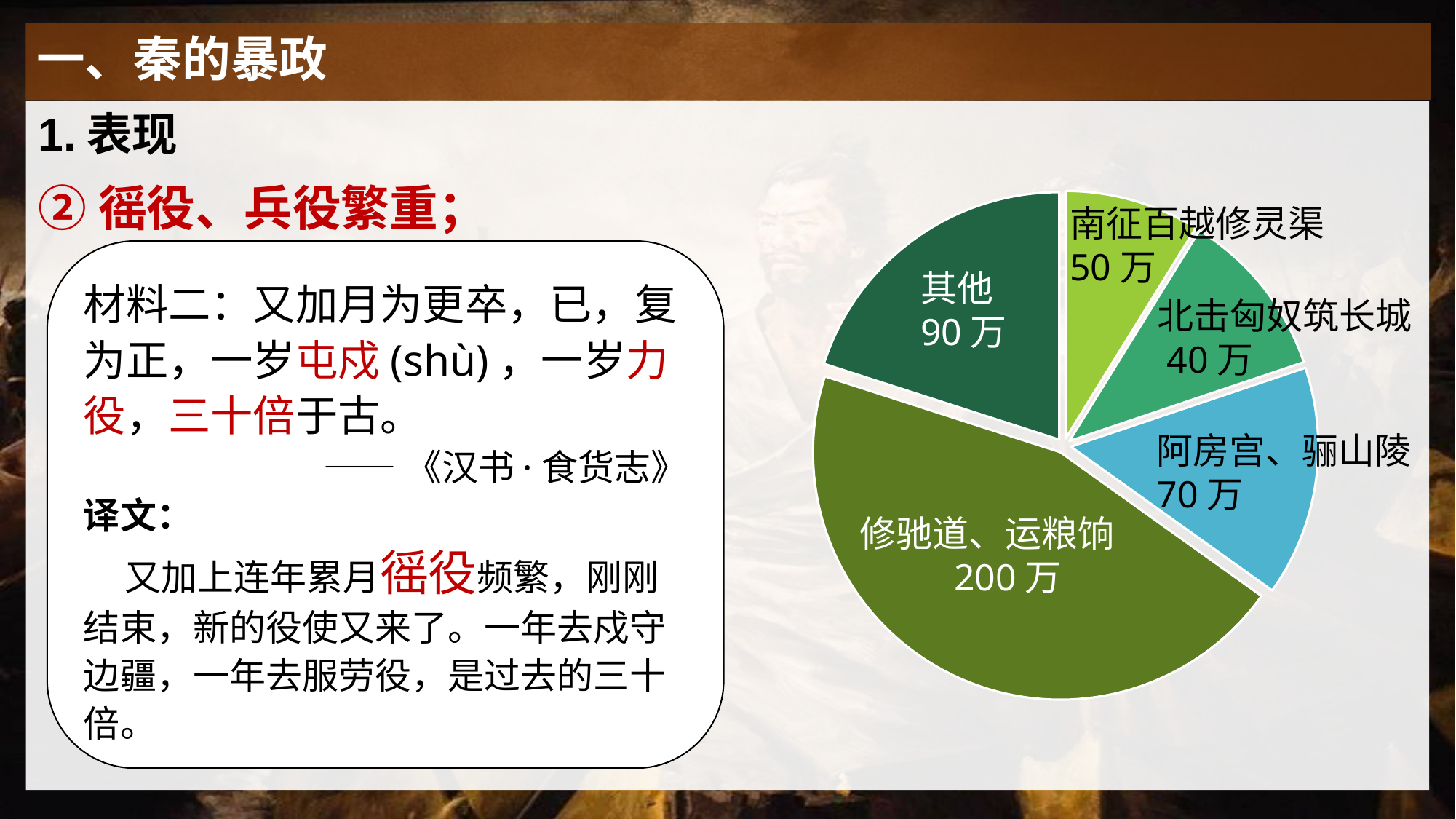
What share of the pie does 其他 represent? 20% What is the difference between the values for 修驰道、运粮饷 and 其他? 110 万 What is the value for 修驰道、运粮饷 in the pie chart? 200 万 What is the value for 其他 in the pie chart? 90 万 Which category has the largest slice in the pie chart? 修驰道、运粮饷 What is the total of all the values shown in the pie chart? 450 万 Which is larger, the value for 南征百越修灵渠 or the value for 阿房宫、骊山陵? 阿房宫、骊山陵 What is the value for 北击匈奴筑长城 in the pie chart? 40 万 What is the value for 阿房宫、骊山陵 in the pie chart? 70 万 What kind of chart is shown on the right side of the slide? pie chart Which category has the smallest slice in the pie chart? 北击匈奴筑长城 How many slices does the pie chart have? 5